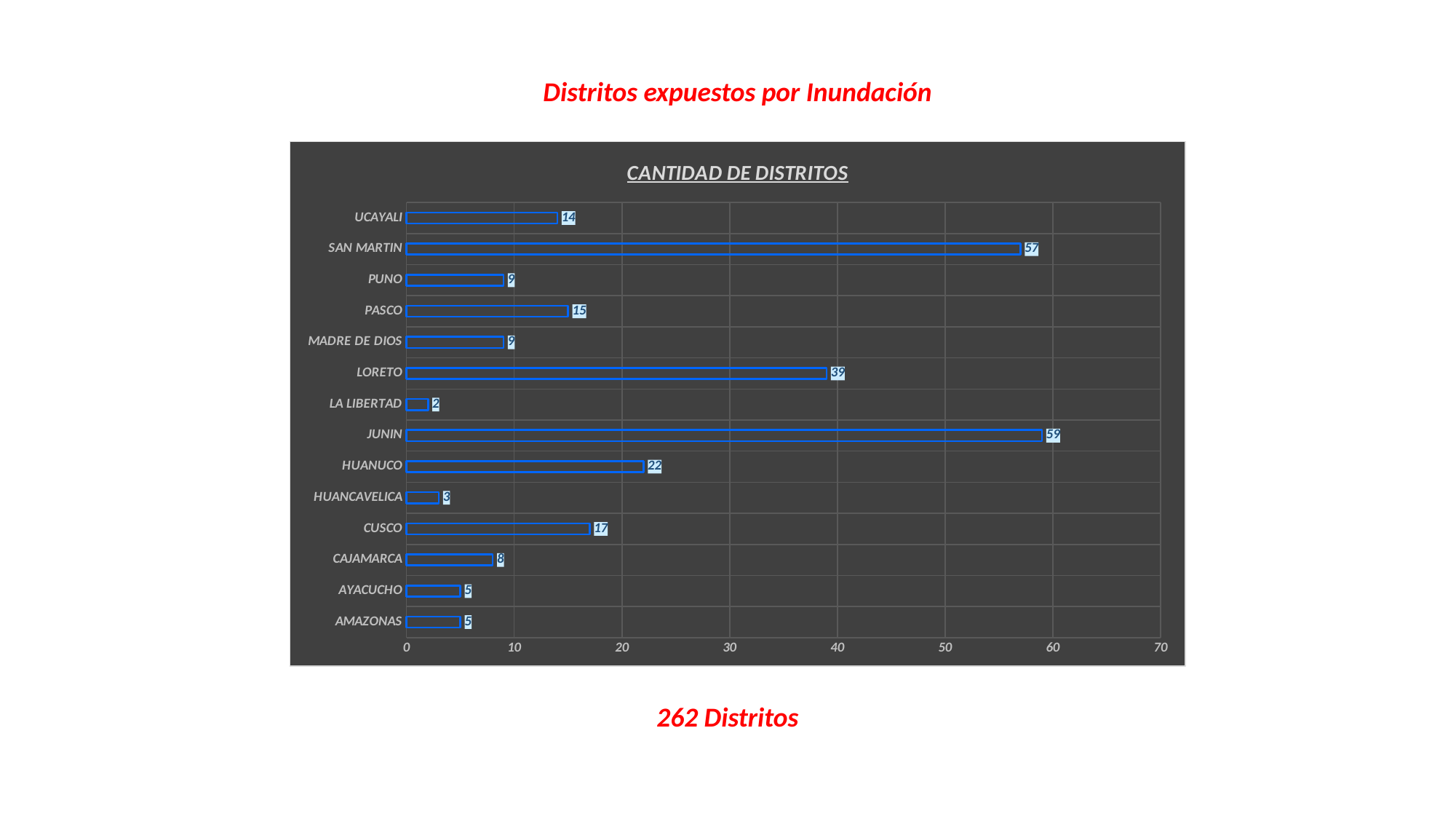
How many categories are shown in the chart? 14 What is the value for LORETO? 39 What is the difference between the values for LORETO and HUANUCO? 17 What is the difference between the values for JUNIN and SAN MARTIN? 2 What is the value for HUANUCO? 22 What is the title of the chart? CANTIDAD DE DISTRITOS Which category has the lowest value? LA LIBERTAD What is the value for SAN MARTIN? 57 Which category has the highest value? JUNIN What kind of chart is shown? bar chart Is the value for LORETO greater or less than 30? greater Which is larger, the value for CUSCO or the value for PASCO? CUSCO